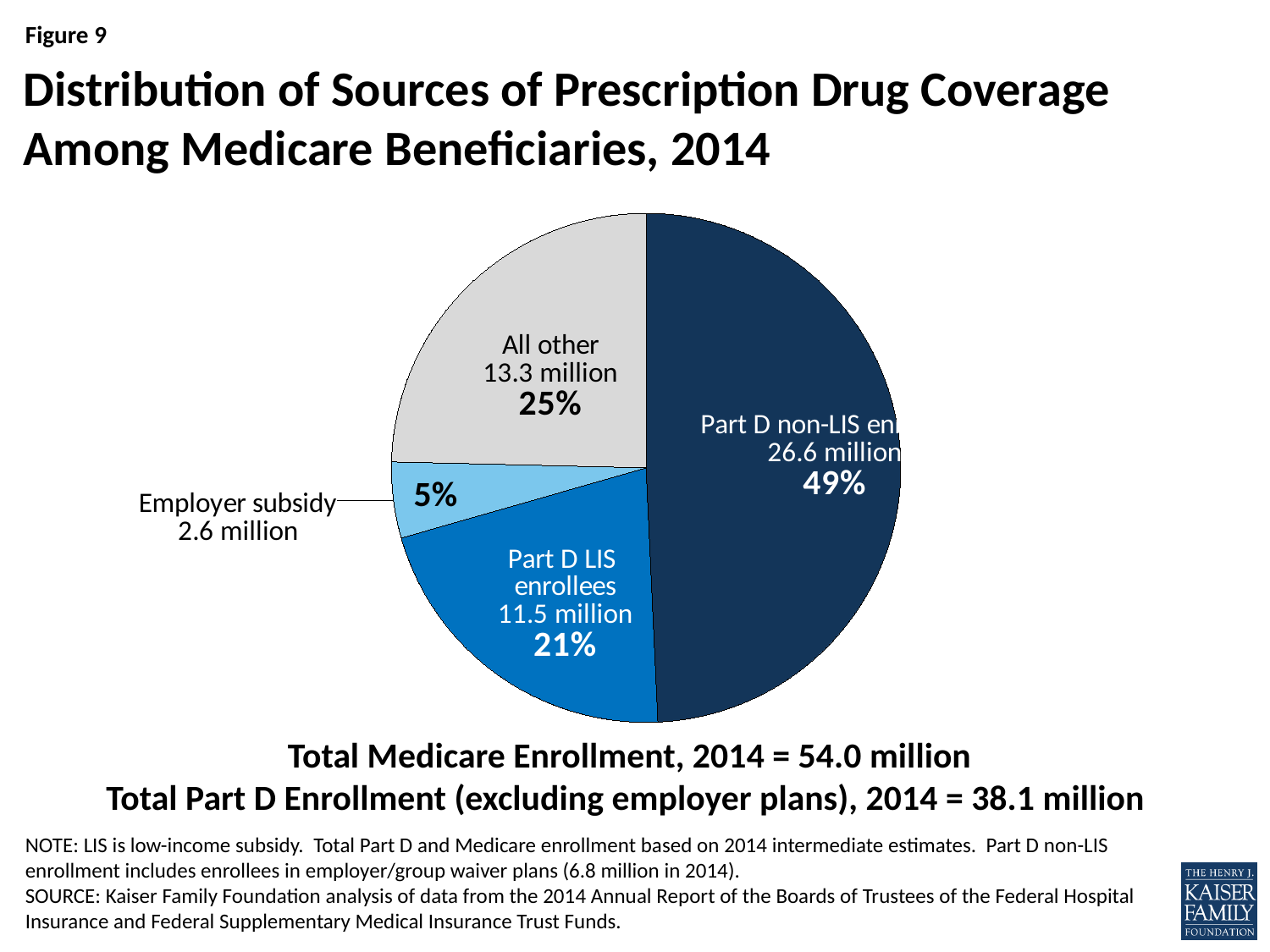
Which is larger, the All other slice or the Part D LIS enrollees slice? All other How many slices does the pie chart have? 4 What share of the pie is All other? 25% What share of the pie is Part D non-LIS enrollees? 49% Which slice of the pie is the smallest? Employer subsidy How many million beneficiaries are in the Employer subsidy slice? 2.6 million What is the difference in millions between Part D non-LIS enrollees and Part D LIS enrollees? 15.1 million What kind of chart is shown on the slide? pie chart Which slice of the pie is the largest? Part D non-LIS enrollees What share of the pie is Employer subsidy? 5% How many million beneficiaries are in the All other slice? 13.3 million